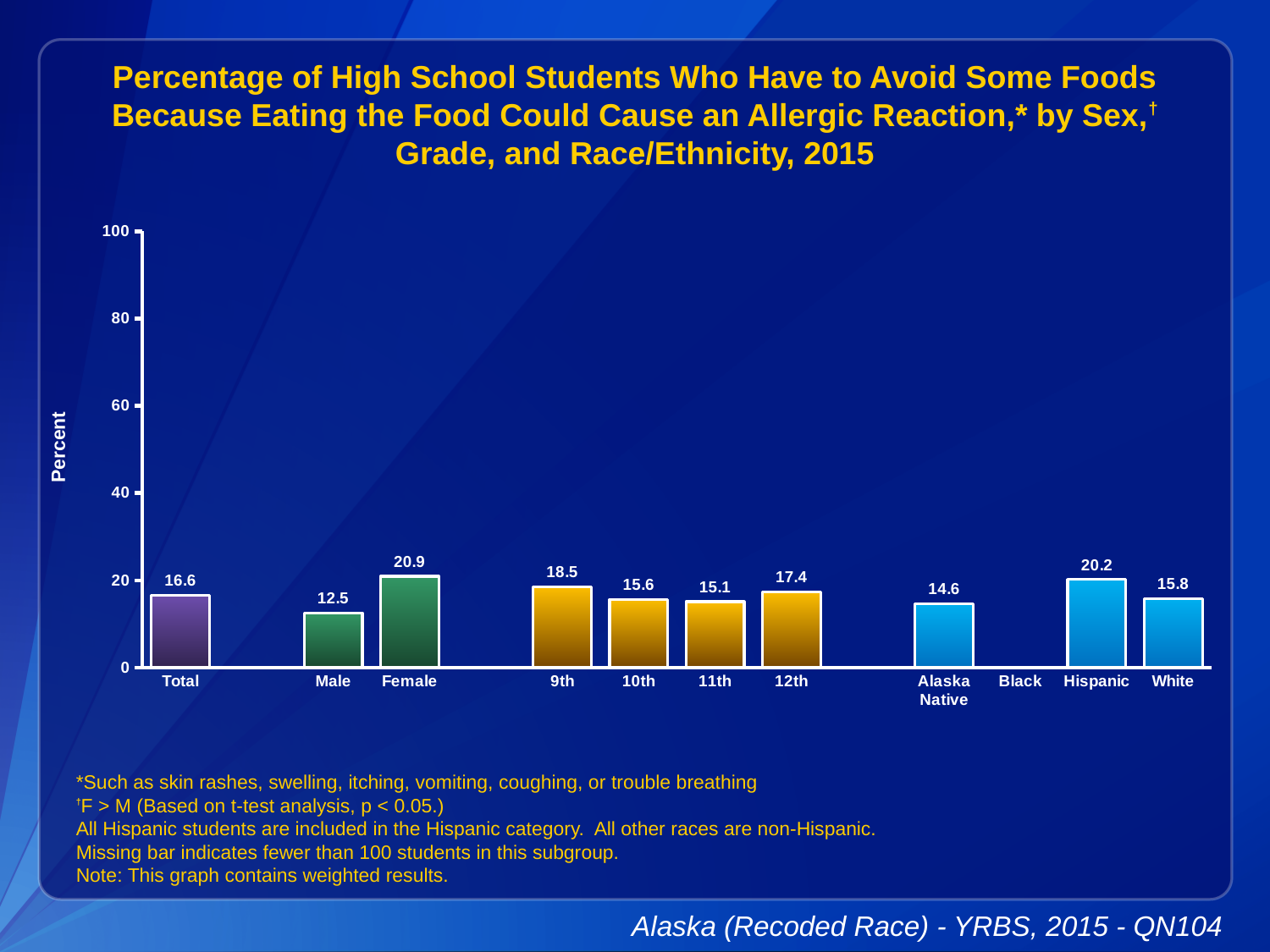
What is the value for 11th grade? 15.1 Which category has the lowest value among the bars shown? Male Is the value for Hispanic greater or less than 20? greater What is the label of the y axis? Percent Which is larger, the value for 9th grade or the value for 12th grade? 9th What is the value for Total? 16.6 What is the difference between the Female and Male values? 8.4 What kind of chart is this? bar chart What is the value for Female? 20.9 Which category has the highest value? Female What is the value for Alaska Native? 14.6 Which category has no bar shown? Black